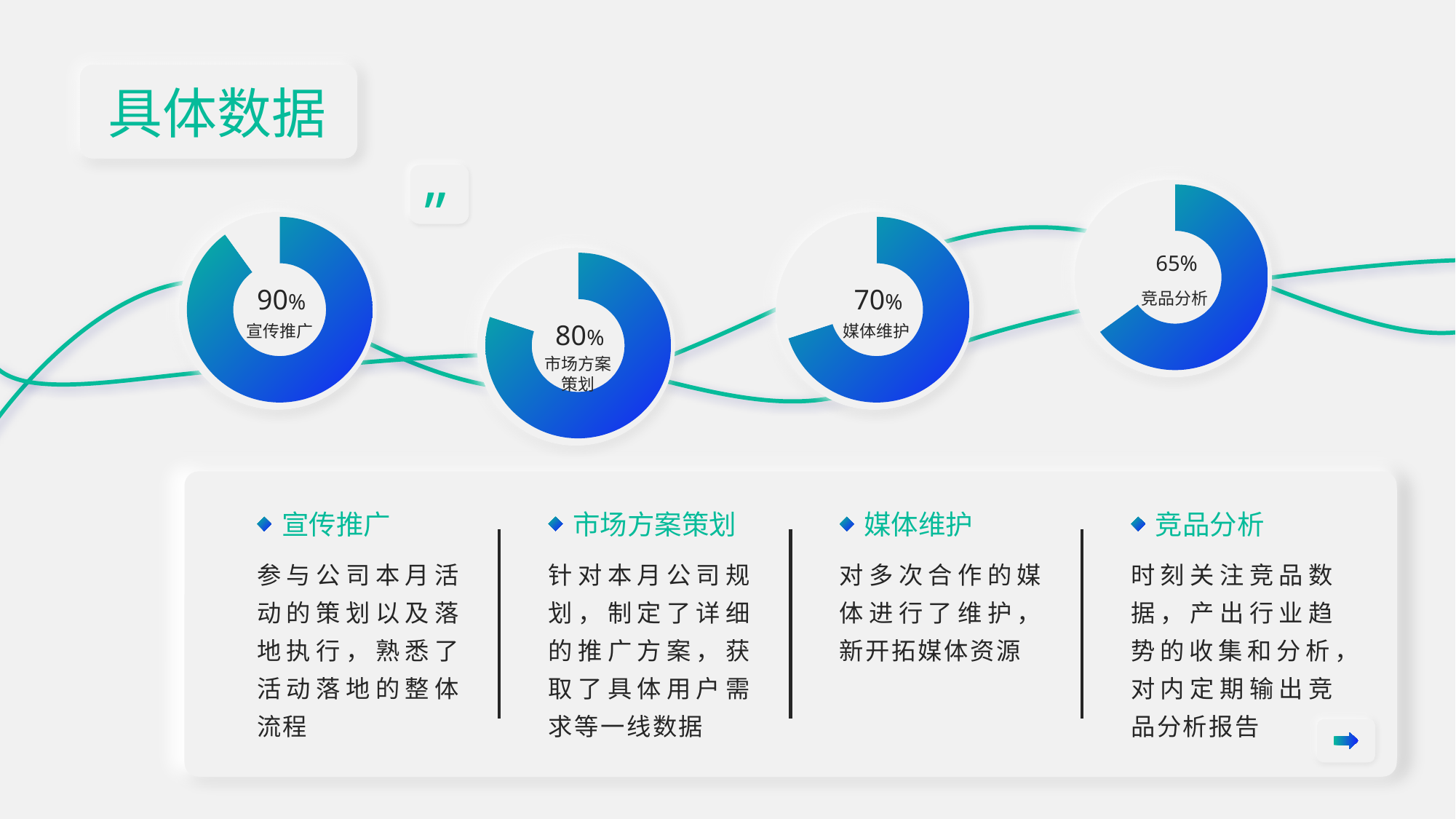
What percentage is shown in the 竞品分析 donut chart? 65% Which shows a larger percentage, the 媒体维护 chart or the 竞品分析 chart? 媒体维护 What percentage is shown in the 市场方案策划 donut chart? 80% What kind of chart is used to show the 宣传推广 value? Donut chart Which of the four donut charts shows the lowest percentage? 竞品分析 Reading the donut charts from left to right, do the percentages rise or fall? Fall What percentage is shown in the 媒体维护 donut chart? 70% What is the difference between the percentage in the 市场方案策划 chart and the percentage in the 媒体维护 chart? 10% Which of the four donut charts shows the highest percentage? 宣传推广 What is the difference between the percentage in the 宣传推广 chart and the percentage in the 竞品分析 chart? 25% What percentage is shown in the 宣传推广 donut chart? 90% How many donut charts are on the slide? 4